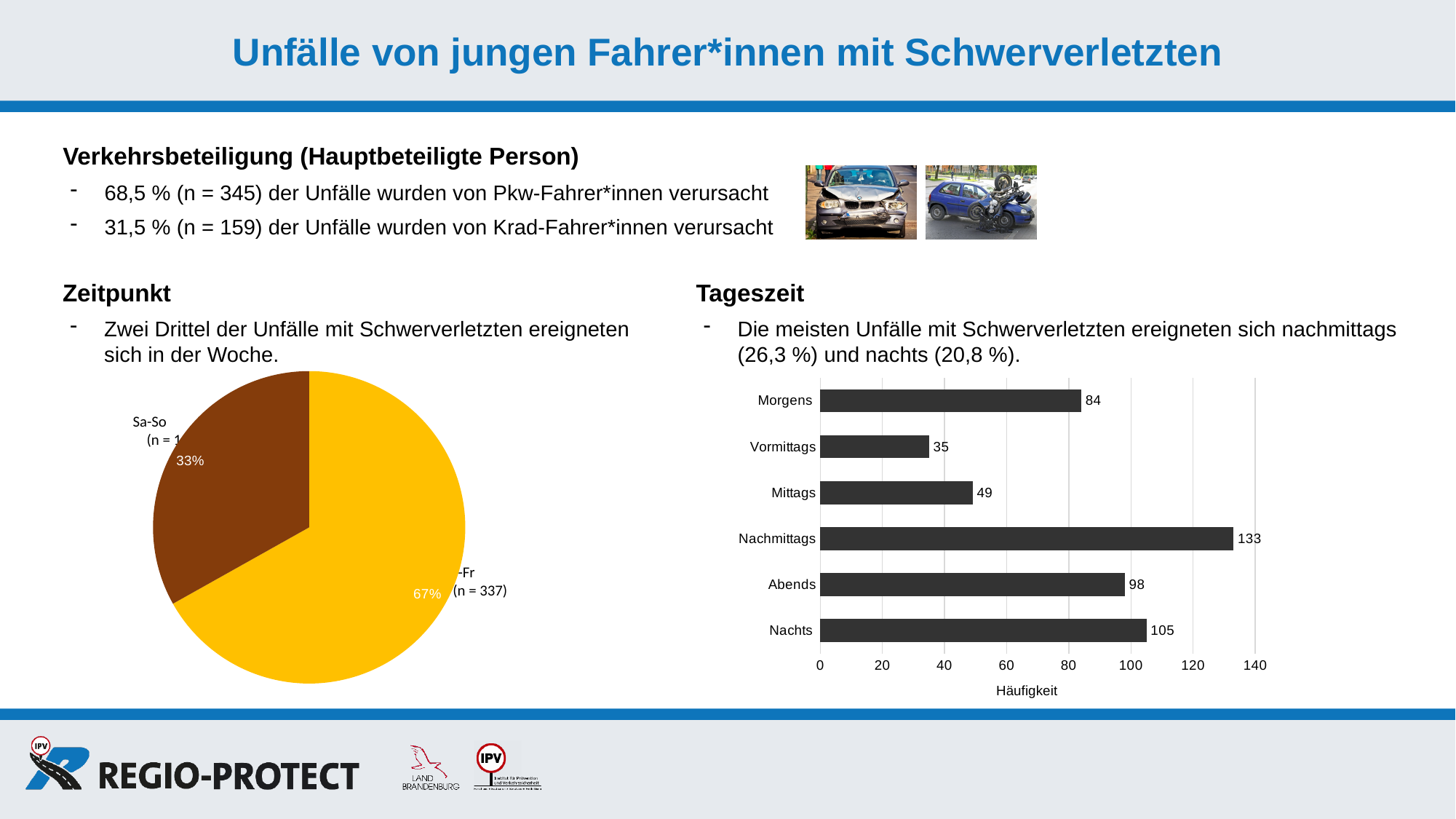
What is the x-axis title of the bar chart under 'Tageszeit'? Häufigkeit In the pie chart under 'Zeitpunkt', what share does the Sa-So slice have? 33% In the bar chart under 'Tageszeit', what is the value for Vormittags? 35 In the bar chart under 'Tageszeit', what is the value for Nachmittags? 133 In the bar chart under 'Tageszeit', which is larger, the value for Morgens or the value for Abends? Abends How many categories are shown in the bar chart under 'Tageszeit'? 6 In the bar chart under 'Tageszeit', which category has the lowest value? Vormittags In the bar chart under 'Tageszeit', what is the difference between the values for Nachmittags and Nachts? 28 In the bar chart under 'Tageszeit', which category has the highest value? Nachmittags In the bar chart under 'Tageszeit', is the value for Mittags greater or less than 60? less In the bar chart under 'Tageszeit', what is the value for Nachts? 105 What kind of chart is shown under 'Tageszeit'? bar chart